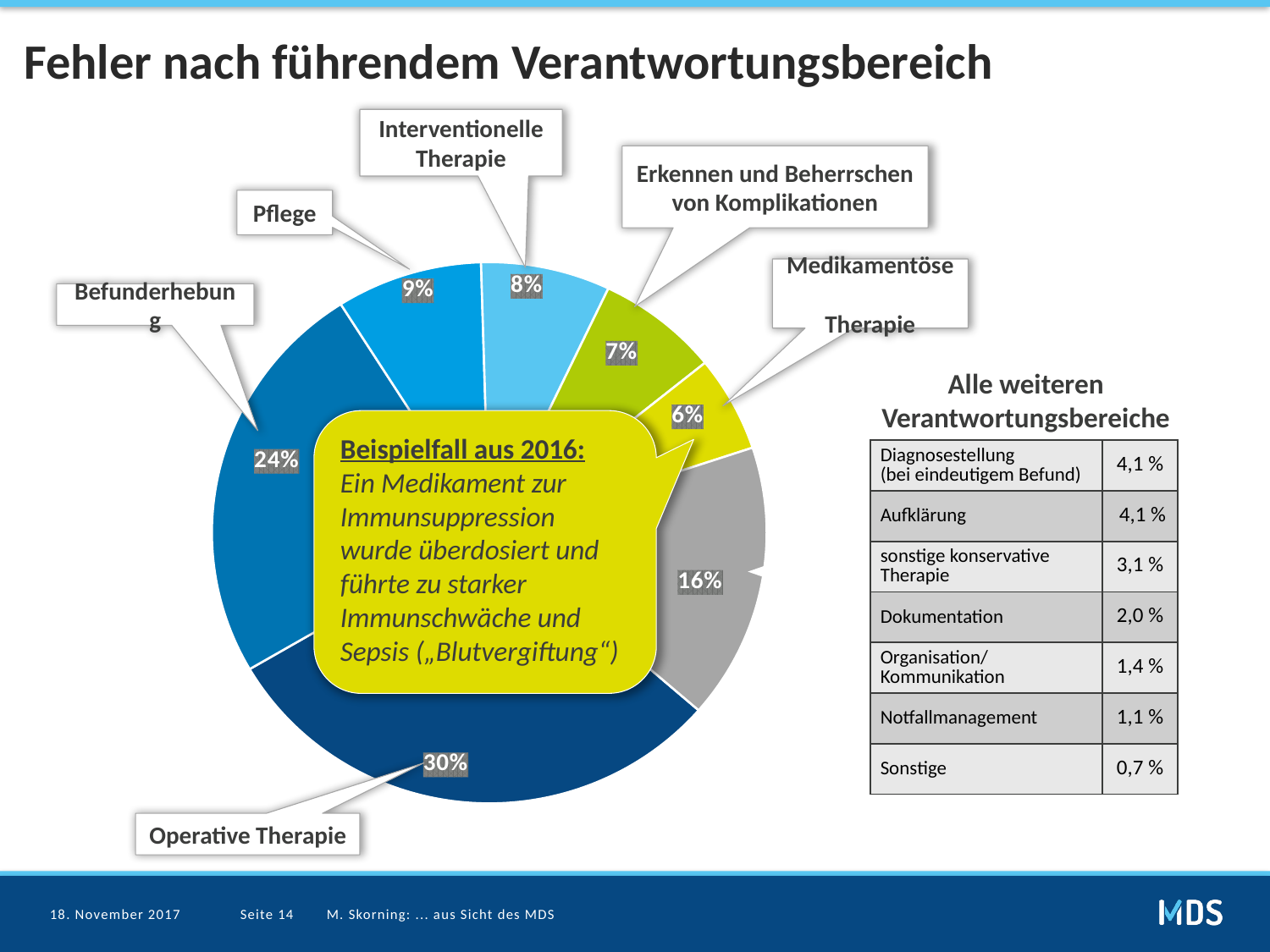
By how many percentage points is Operative Therapie larger than Befunderhebung in the pie chart? 6 Which labelled category has the largest slice in the pie chart? Operative Therapie What percentage does the pie chart show for Erkennen und Beherrschen von Komplikationen? 7% What percentage does the pie chart show for Interventionelle Therapie? 8% What percentage does the pie chart show for Befunderhebung? 24% What percentage does the pie chart show for Medikamentöse Therapie? 6% What kind of chart is shown on the slide? Pie chart What percentage does the pie chart show for Operative Therapie? 30% Which labelled category has the smallest slice in the pie chart? Medikamentöse Therapie What percentage does the pie chart show for Pflege? 9% How many slices does the pie chart have? 7 Which slice is larger in the pie chart, Pflege or Interventionelle Therapie? Pflege